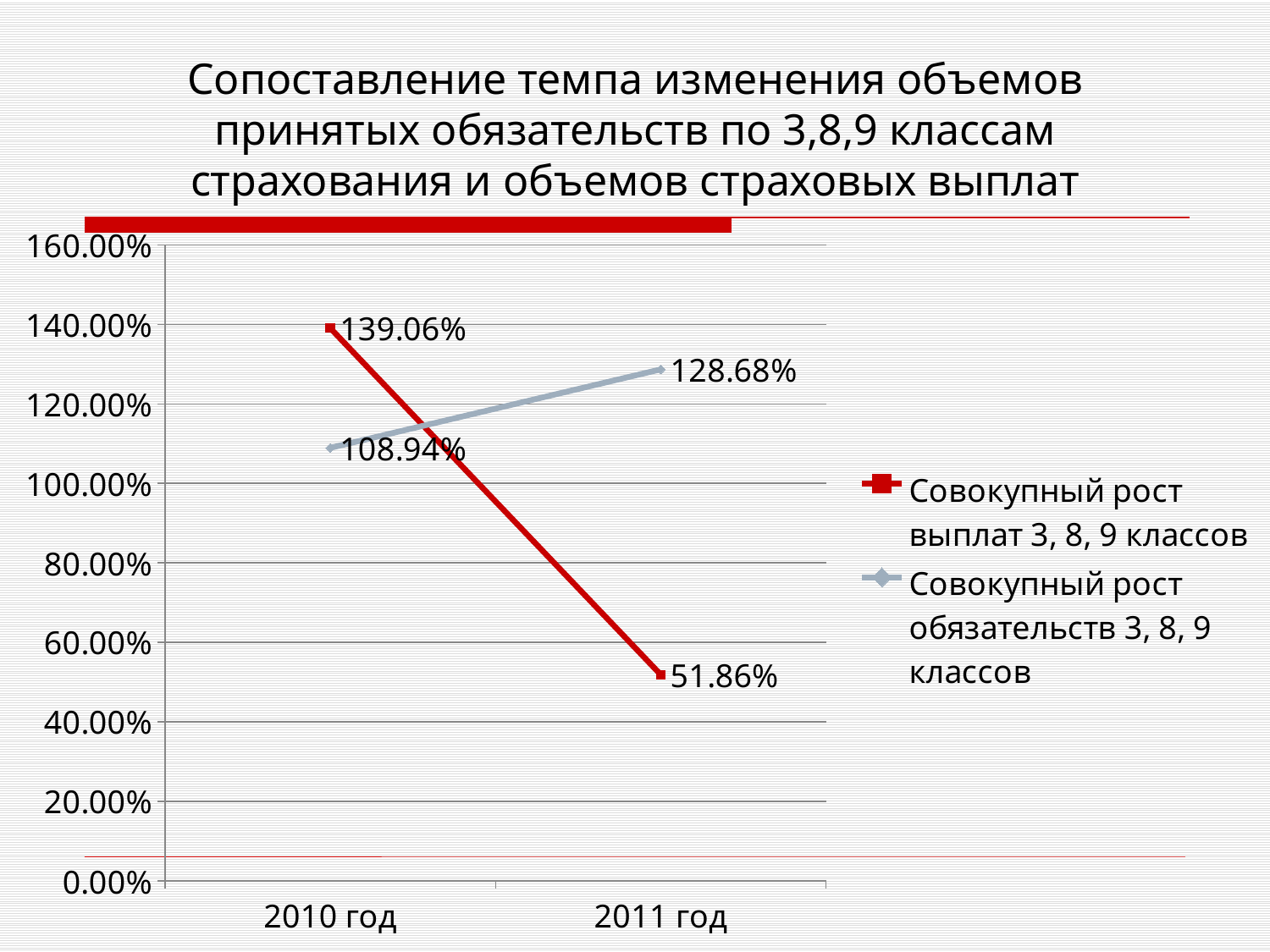
What kind of chart is shown on the slide? line chart What is the value of 'Совокупный рост обязательств 3, 8, 9 классов' for 2010 год? 108.94% Does the 'Совокупный рост обязательств 3, 8, 9 классов' series rise or fall from 2010 год to 2011 год? rise Which series has the higher value in 2010 год? Совокупный рост выплат 3, 8, 9 классов Which series has the higher value in 2011 год? Совокупный рост обязательств 3, 8, 9 классов Does the 'Совокупный рост выплат 3, 8, 9 классов' series rise or fall from 2010 год to 2011 год? fall What is the value of 'Совокупный рост обязательств 3, 8, 9 классов' for 2011 год? 128.68% What is the value of 'Совокупный рост выплат 3, 8, 9 классов' for 2010 год? 139.06% What is the difference between the 2010 год and 2011 год values for 'Совокупный рост выплат 3, 8, 9 классов'? 87.20% What is the difference between the two series' values in 2011 год? 76.82% What is the value of 'Совокупный рост выплат 3, 8, 9 классов' for 2011 год? 51.86% How many series does the legend list? 2